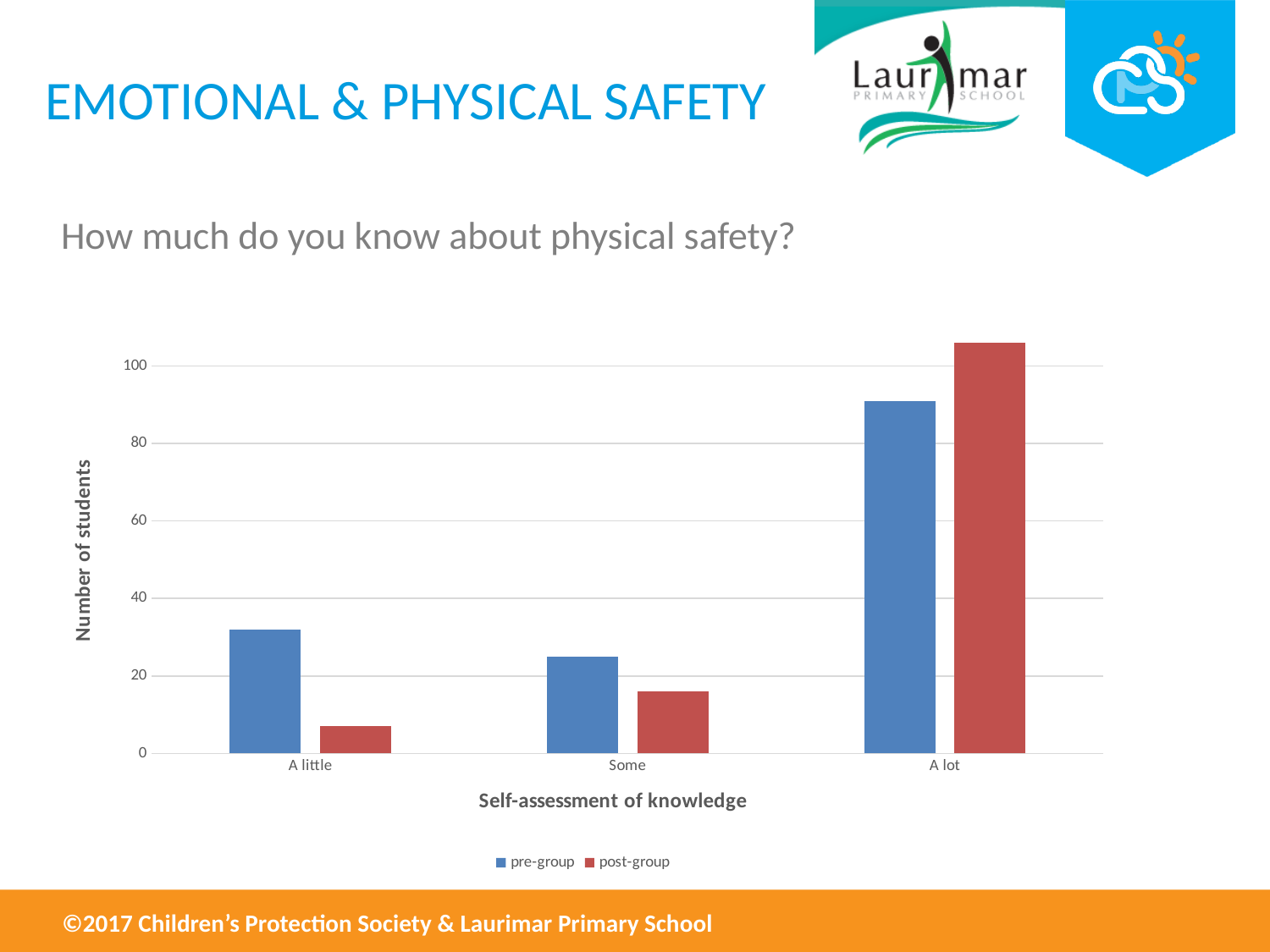
For the A lot category, which is larger: the pre-group value or the post-group value? post-group Which category has the lowest post-group value? A little What kind of chart is shown on the slide? bar chart Is the post-group value for A lot greater or less than 100? greater Which category has the highest pre-group value? A lot What is the label of the y axis? Number of students Which category has the lowest pre-group value? Some How many categories are shown on the x axis? 3 For the A little category, which is larger: the pre-group value or the post-group value? pre-group Is the post-group value for Some greater or less than 20? less Is the pre-group value for A little greater or less than 40? less How many series does the legend list? 2